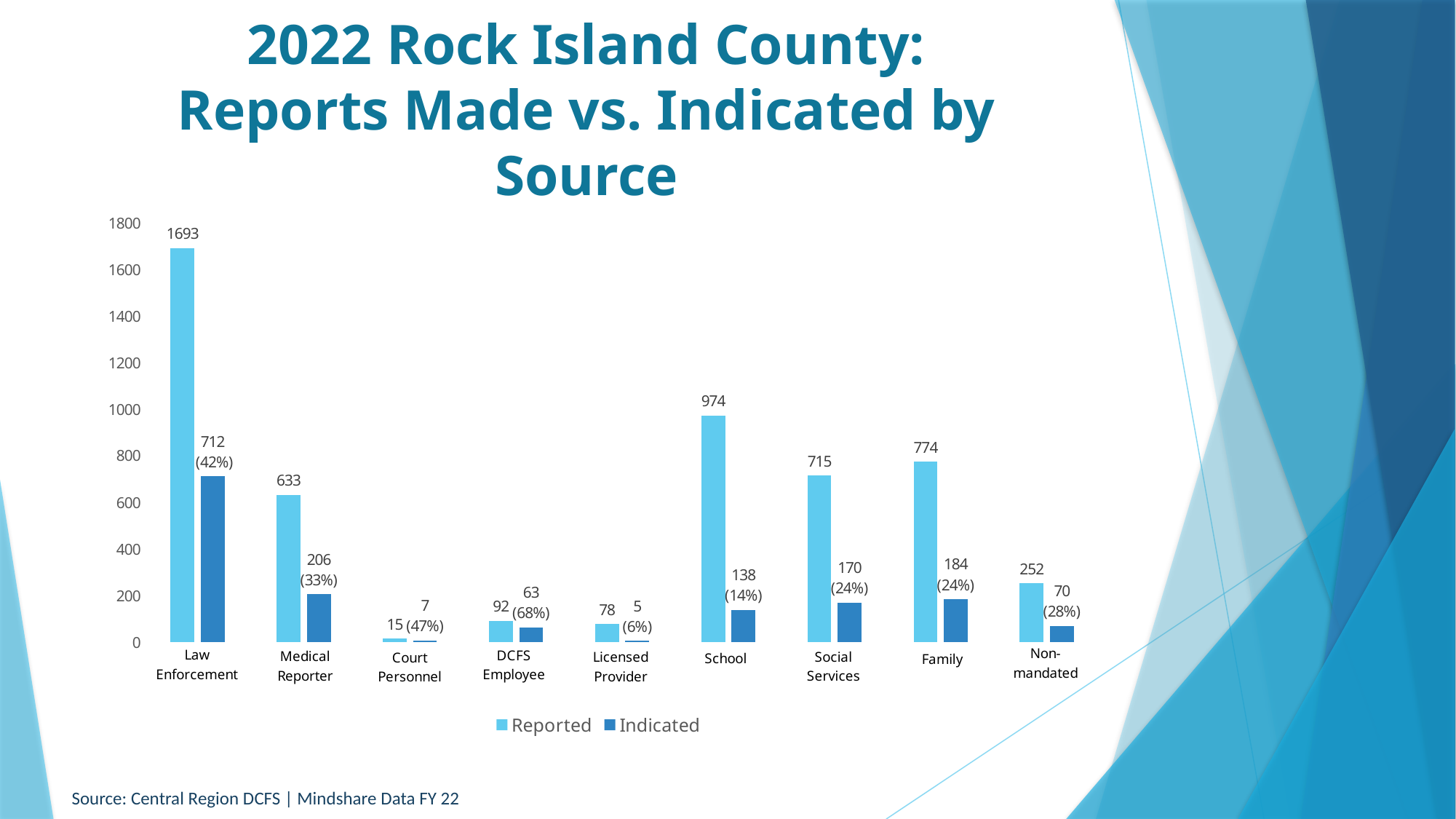
What percentage is shown next to the Indicated value for DCFS Employee? 68% What is the difference between the Reported and Indicated values for Medical Reporter? 427 What is the Indicated value for School? 138 What is the Reported value for Social Services? 715 What kind of chart is shown on the slide? bar chart Is the Reported value for School greater or less than 1000? less Which is larger, the Reported value for Family or the Reported value for Social Services? Family Which source has the highest Reported value? Law Enforcement Which source has the lowest Indicated value? Licensed Provider What is the Reported value for Law Enforcement? 1693 How many series does the legend list? 2 How many sources are shown on the x axis? 9